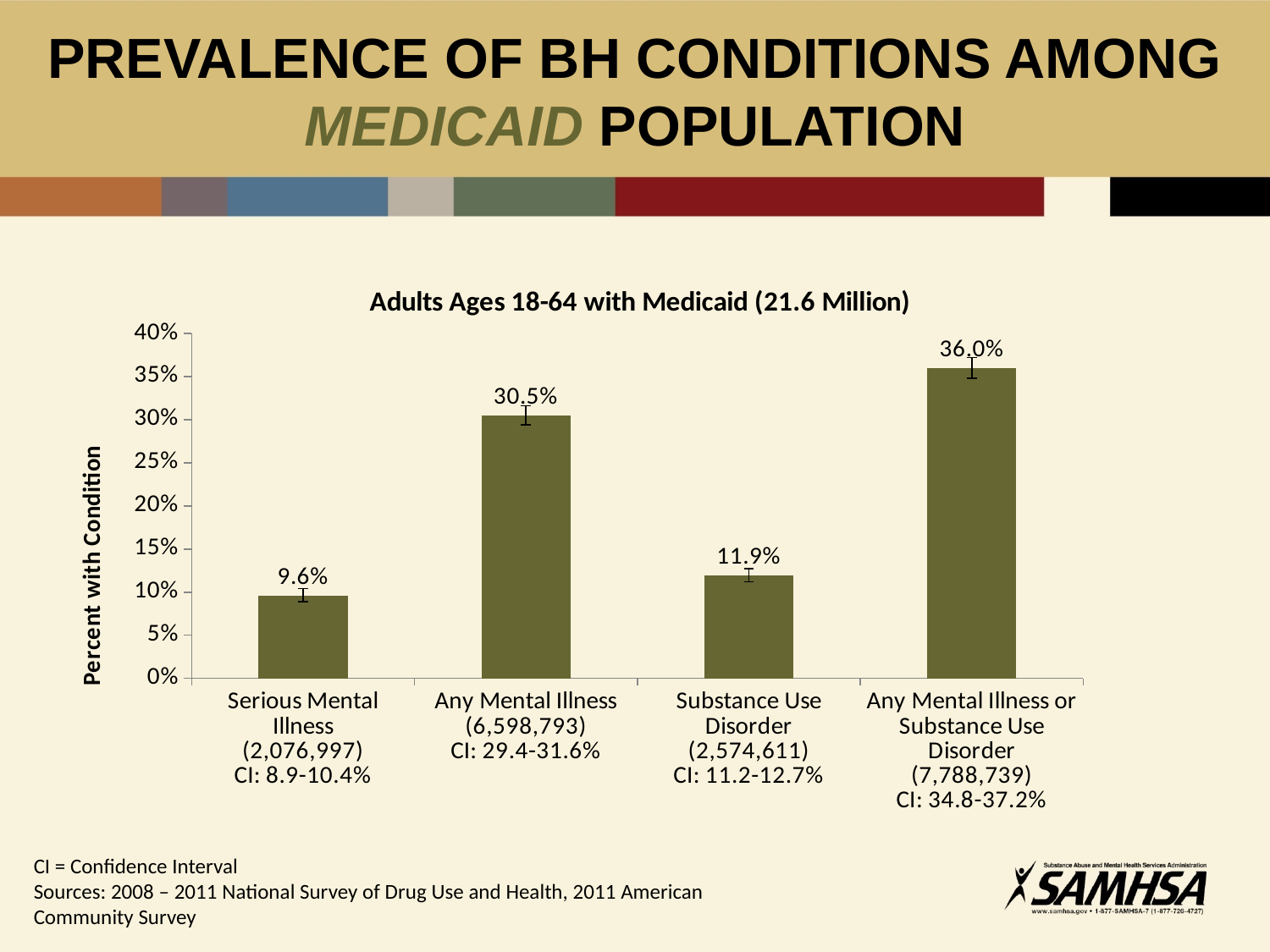
Which category has the highest value? Any Mental Illness or Substance Use Disorder What is the value for Serious Mental Illness? 9.6% What is the difference between the values for Substance Use Disorder and Serious Mental Illness? 2.3% What is the title of the chart? Adults Ages 18-64 with Medicaid (21.6 Million) Which is larger, the value for Any Mental Illness or the value for Substance Use Disorder? Any Mental Illness What is the value for Any Mental Illness or Substance Use Disorder? 36.0% What is the value for Any Mental Illness? 30.5% How many categories are shown on the chart? 4 What is the difference between the values for Any Mental Illness or Substance Use Disorder and Any Mental Illness? 5.5% What kind of chart is shown on the slide? Bar chart What is the value for Substance Use Disorder? 11.9% Which category has the lowest value? Serious Mental Illness